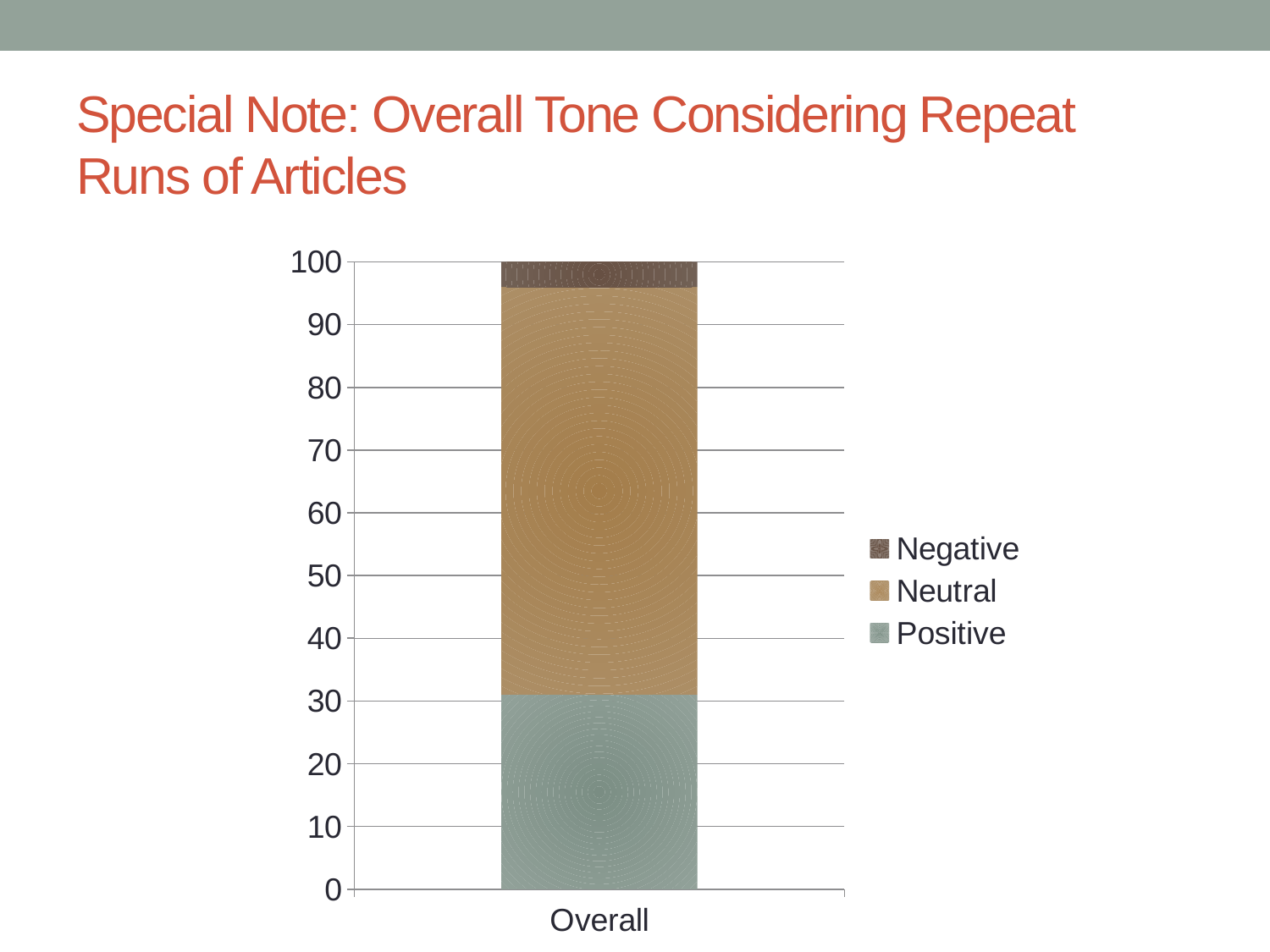
What is the label of the single category on the x axis? Overall How many series does the legend list? 3 Which series makes up the largest segment of the Overall bar? Neutral Which segment of the Overall bar is larger, Positive or Negative? Positive What is the total height of the stacked Overall bar? 100 Is the Negative segment of the Overall bar greater or less than 10? less What kind of chart is shown on the slide? Stacked bar chart Is the Neutral segment of the Overall bar greater or less than 50? greater Which series makes up the smallest segment of the Overall bar? Negative Is the Positive segment of the Overall bar greater or less than 20? greater How many categories are shown on the x axis? 1